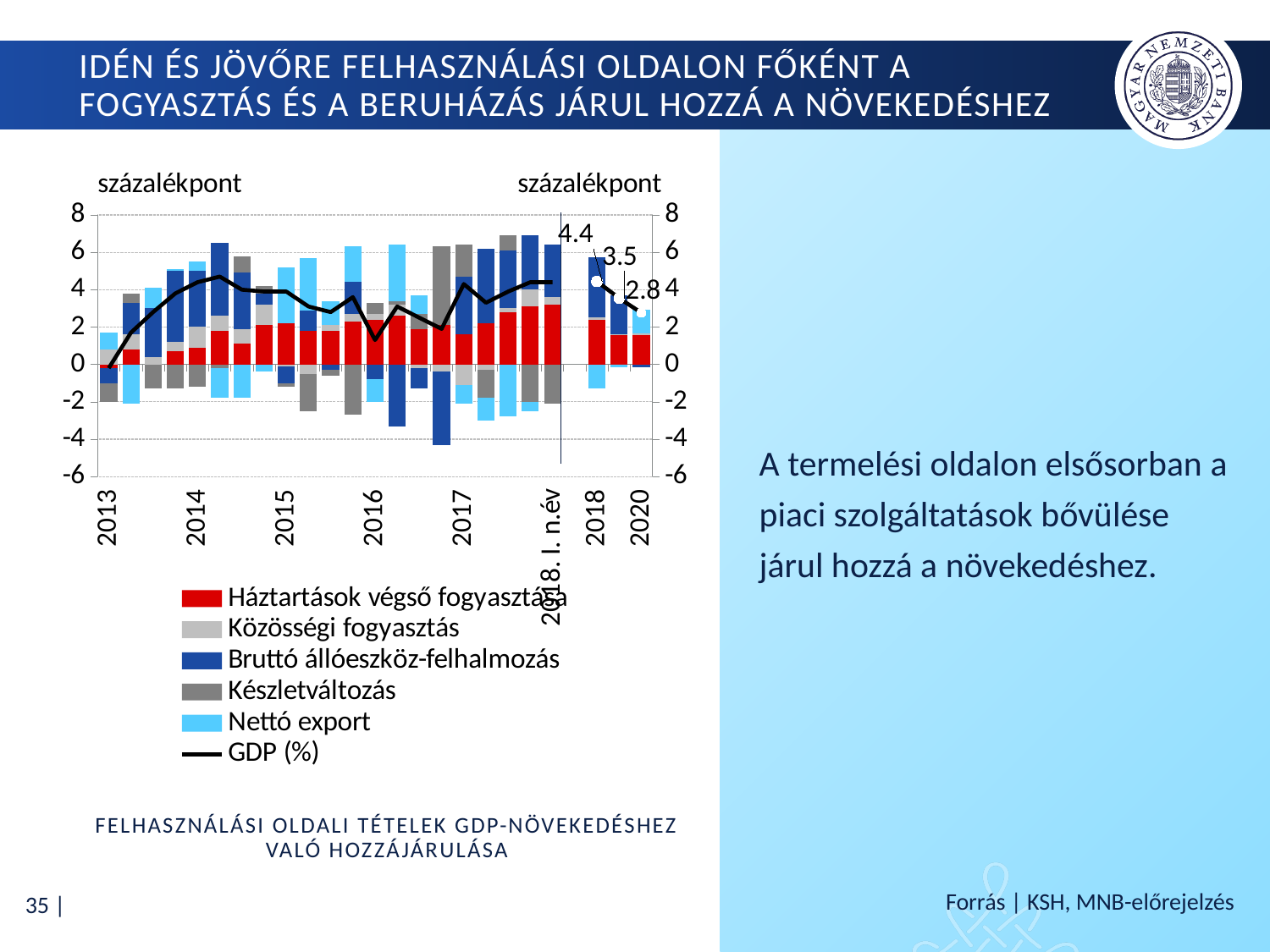
Which legend entry is drawn as a line rather than bars? GDP (%) What GDP (%) value is labelled for 2020? 2.8 What unit is shown at the top of the vertical axes? százalékpont Is the labelled GDP (%) value for 2020 greater or less than 4? less What is the highest GDP (%) value labelled on the chart? 4.4 Do the labelled GDP (%) values rise or fall from 2018 to 2020? Fall Which is larger, the GDP value labelled 4.4 or the one labelled 3.5? 4.4 What GDP (%) value is labelled for 2018? 4.4 How many series does the legend list? 6 What is the lowest GDP (%) value labelled on the chart? 2.8 What is the difference between the labelled GDP values 4.4 and 2.8? 1.6 What kind of chart is shown on the slide? Stacked bar chart with a line